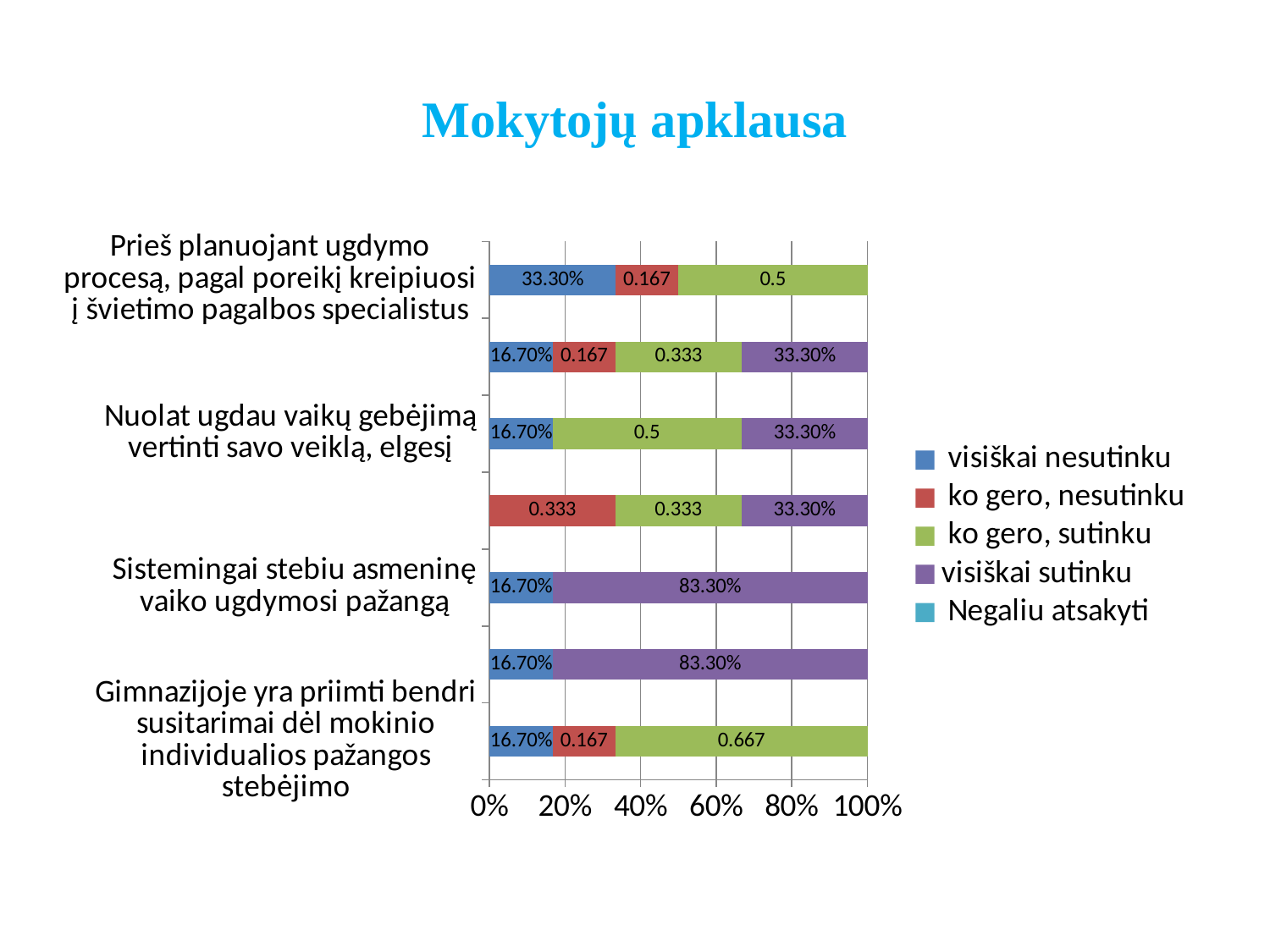
For "Sistemingai stebiu asmeninę vaiko ugdymosi pažangą", which is larger: "visiškai nesutinku" or "visiškai sutinku"? visiškai sutinku What is the value of "ko gero, sutinku" for "Gimnazijoje yra priimti bendri susitarimai dėl mokinio individualios pažangos stebėjimo"? 0.667 What is the value of "ko gero, sutinku" for "Prieš planuojant ugdymo procesą, pagal poreikį kreipiuosi į švietimo pagalbos specialistus"? 0.5 What is the title of the slide? Mokytojų apklausa What is the value of "visiškai sutinku" for "Nuolat ugdau vaikų gebėjimą vertinti savo veiklą, elgesį"? 33.30% What kind of chart is shown on the slide? bar chart What is the value of "ko gero, nesutinku" for "Gimnazijoje yra priimti bendri susitarimai dėl mokinio individualios pažangos stebėjimo"? 0.167 What is the value of "visiškai nesutinku" for "Prieš planuojant ugdymo procesą, pagal poreikį kreipiuosi į švietimo pagalbos specialistus"? 33.30% How many bars are plotted in the chart? 7 What is the last entry in the chart legend? Negaliu atsakyti How many series does the legend list? 5 What is the value of "visiškai sutinku" for "Sistemingai stebiu asmeninę vaiko ugdymosi pažangą"? 83.30%